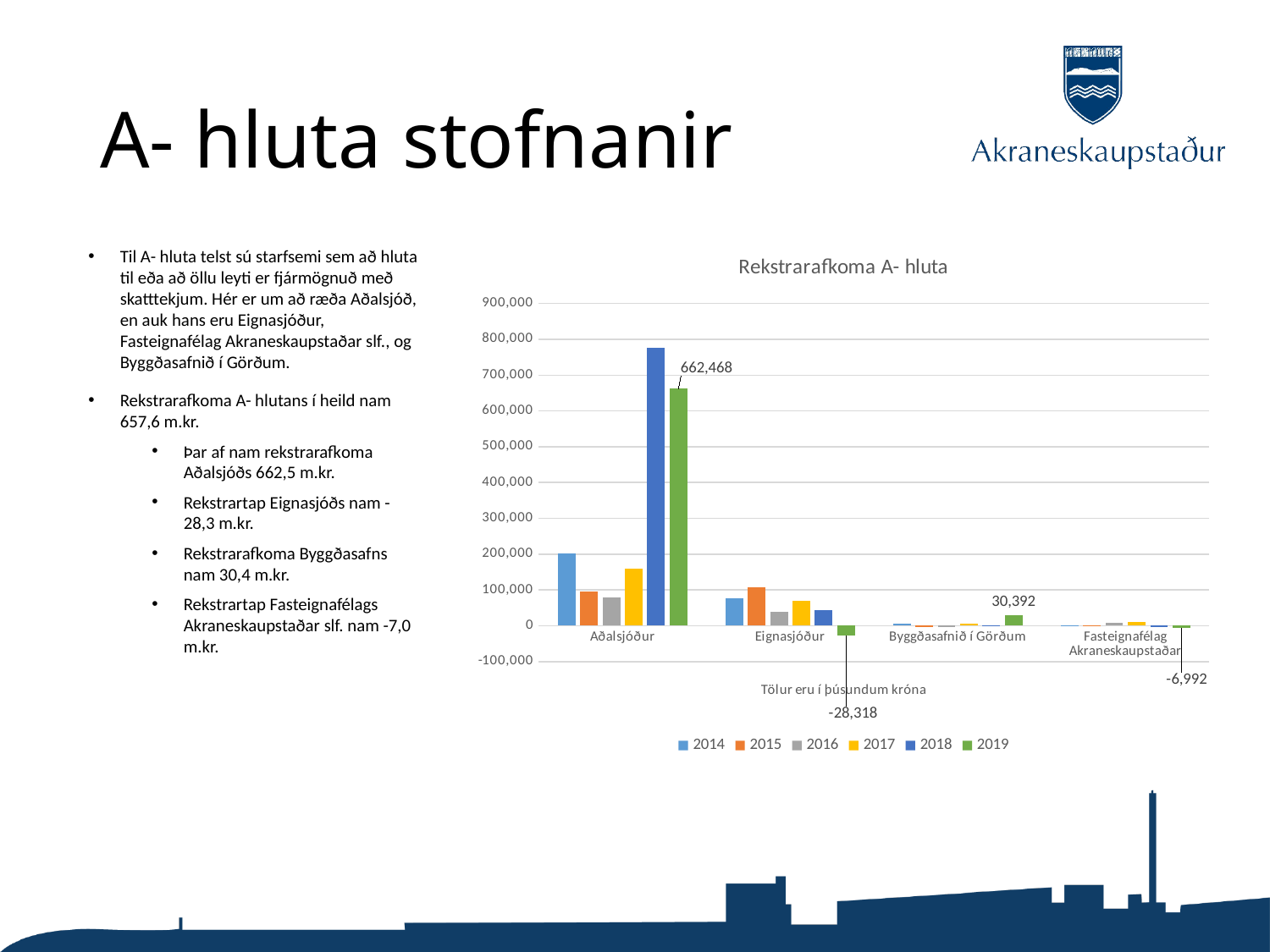
Which category has the highest 2019 value? Aðalsjóður Is the 2018 value for Aðalsjóður greater or less than 700,000? greater What is the 2019 value for Fasteignafélag Akraneskaupstaðar? -6,992 What is the difference between the 2019 values for Aðalsjóður and Byggðasafnið í Görðum? 632,076 What is the 2019 value for Byggðasafnið í Görðum? 30,392 What is the title of the chart? Rekstrarafkoma A- hluta What kind of chart is shown on the slide? bar chart How many categories are shown on the x axis of the chart? 4 What is the 2019 value for Aðalsjóður? 662,468 Which category has the lowest 2019 value? Eignasjóður How many series does the chart legend list? 6 What is the 2019 value for Eignasjóður? -28,318